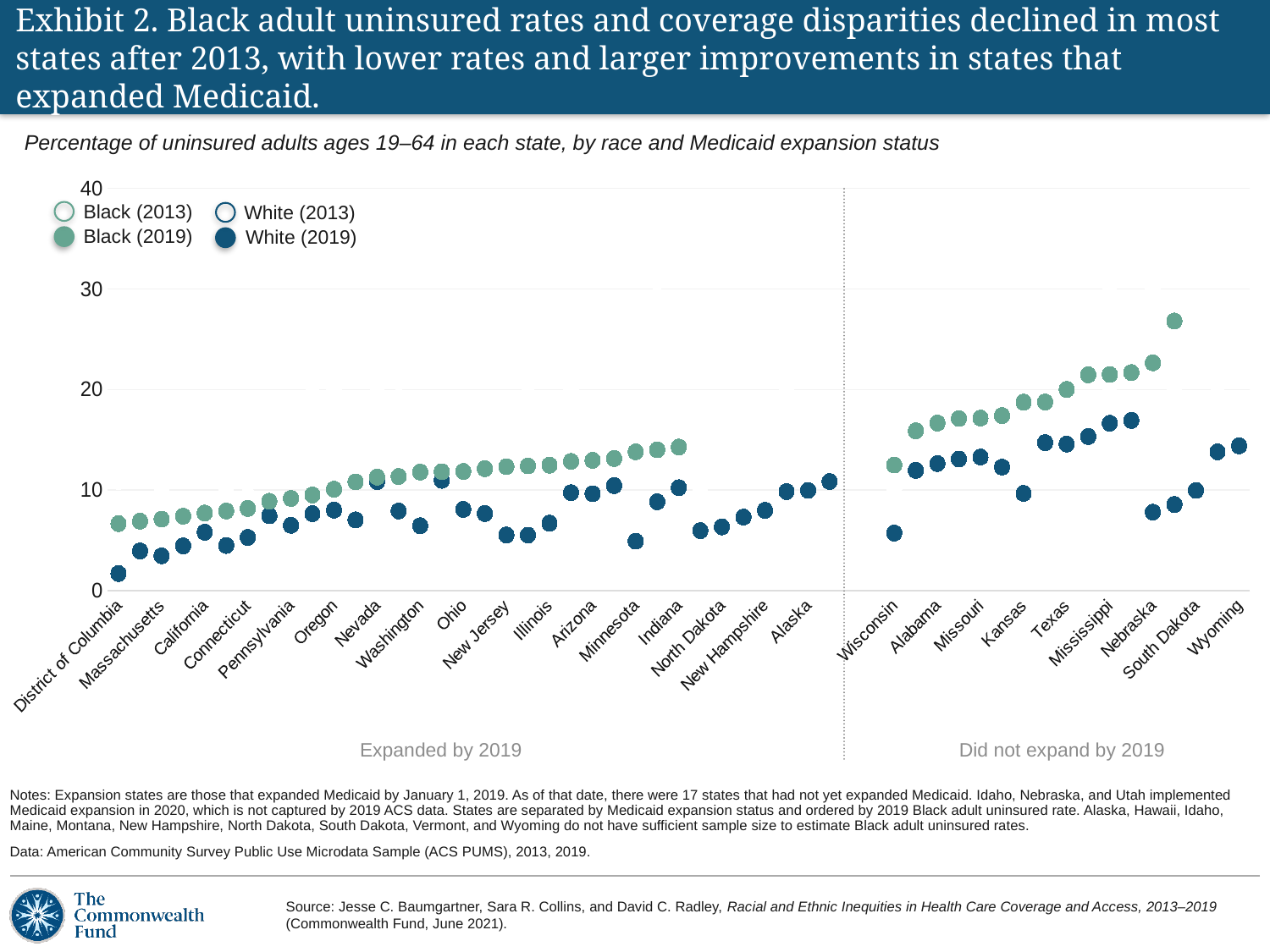
What kind of chart is shown on the slide? Dot (scatter) chart Is the White (2019) value for Wisconsin greater or less than 10? less What are the two group labels shown beneath the x axis? Expanded by 2019; Did not expand by 2019 Is the White (2019) value for District of Columbia greater or less than 10? less What is the highest value shown on the y axis? 40 How many series does the legend list? 4 Within the 'Expanded by 2019' group, do the Black (2019) values rise or fall from left to right? rise For District of Columbia, which is larger: the Black (2019) value or the White (2019) value? Black (2019) How many state labels appear on the x axis in the 'Did not expand by 2019' group? 9 Is the White (2019) value for Wyoming greater or less than 10? greater For Wisconsin, which is larger: the Black (2019) value or the White (2019) value? Black (2019)